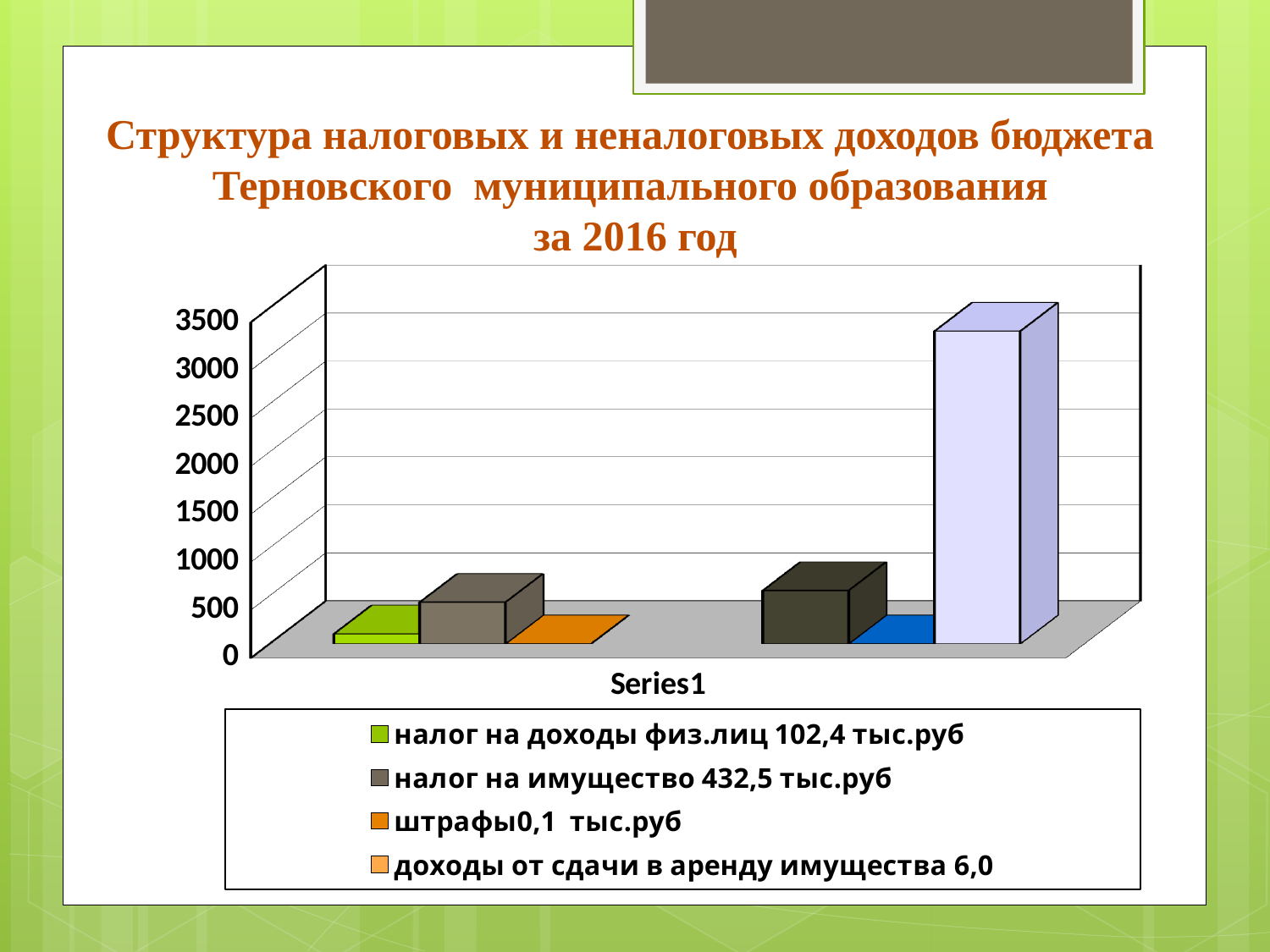
What is the difference between налог на имущество (432,5) and налог на доходы физ.лиц (102,4)? 330,1 Is the value of the tallest bar greater or less than 3000? greater Of the four legend entries, which has the smallest value? штрафы According to the legend, what is the value for налог на доходы физ.лиц? 102,4 тыс.руб Of the four legend entries, which has the largest value? налог на имущество According to the legend, what is the value for штрафы? 0,1 тыс.руб Which is larger, налог на имущество or налог на доходы физ.лиц? налог на имущество What label appears under the horizontal axis of the chart? Series1 How many entries does the chart legend list? 4 What kind of chart is shown on the slide? bar chart According to the legend, what is the value for налог на имущество? 432,5 тыс.руб According to the legend, what is the value for доходы от сдачи в аренду имущества? 6,0